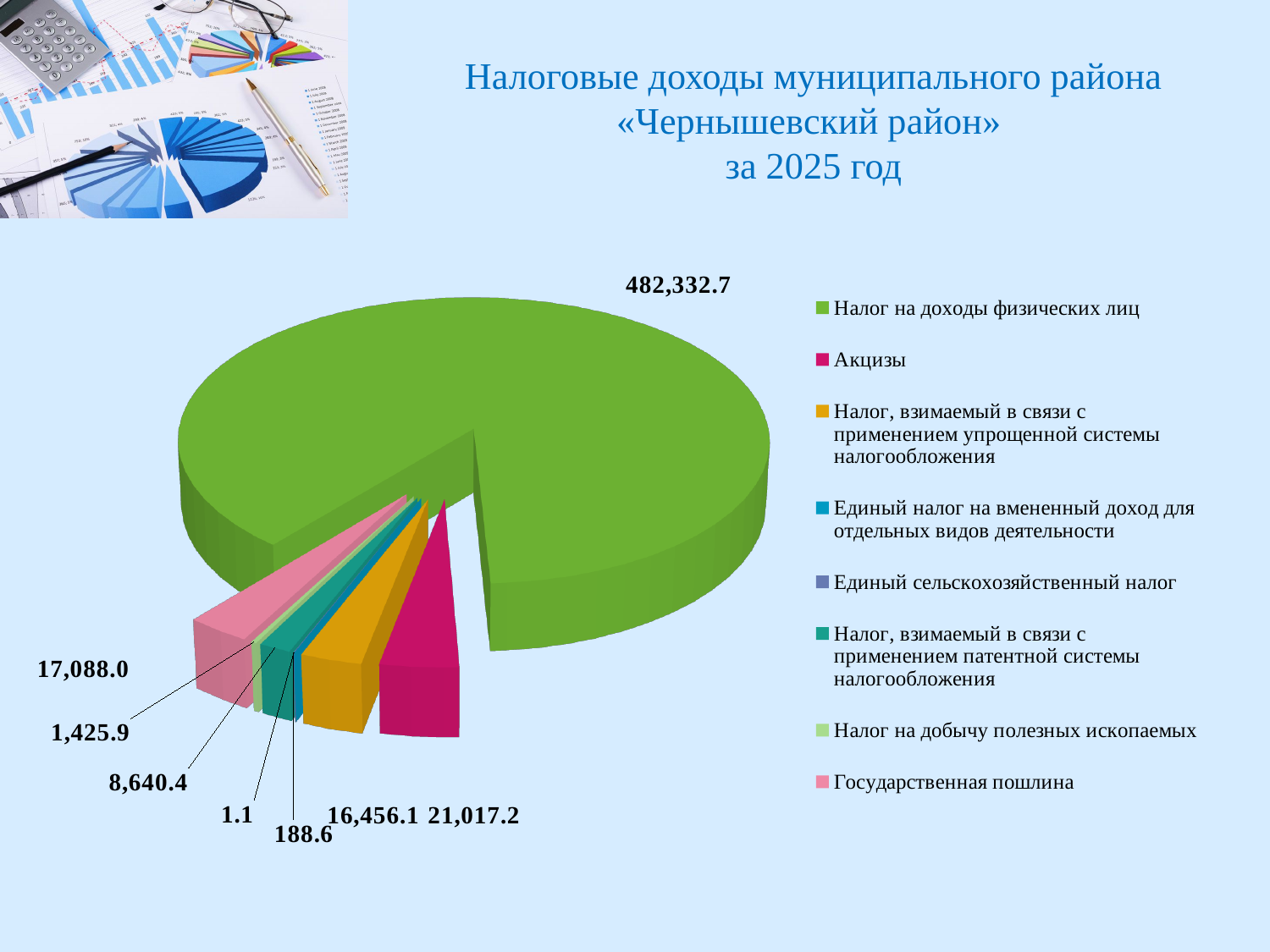
What is the value shown for Налог на доходы физических лиц? 482,332.7 What is the smallest value labelled on the pie chart? 1.1 Which category has the largest slice in the pie chart? Налог на доходы физических лиц What is the difference between the value for Акцизы and the value for Налог, взимаемый в связи с применением упрощенной системы налогообложения? 4,561.1 Which is larger, the value for Акцизы or the value for Государственная пошлина? Акцизы What is the value shown for Налог на добычу полезных ископаемых? 1,425.9 What type of chart is shown on the slide? Pie chart What is the value shown for Налог, взимаемый в связи с применением патентной системы налогообложения? 8,640.4 What is the value shown for Акцизы? 21,017.2 What is the value shown for Налог, взимаемый в связи с применением упрощенной системы налогообложения? 16,456.1 What is the value shown for Государственная пошлина? 17,088.0 How many categories does the legend of the pie chart list? 8